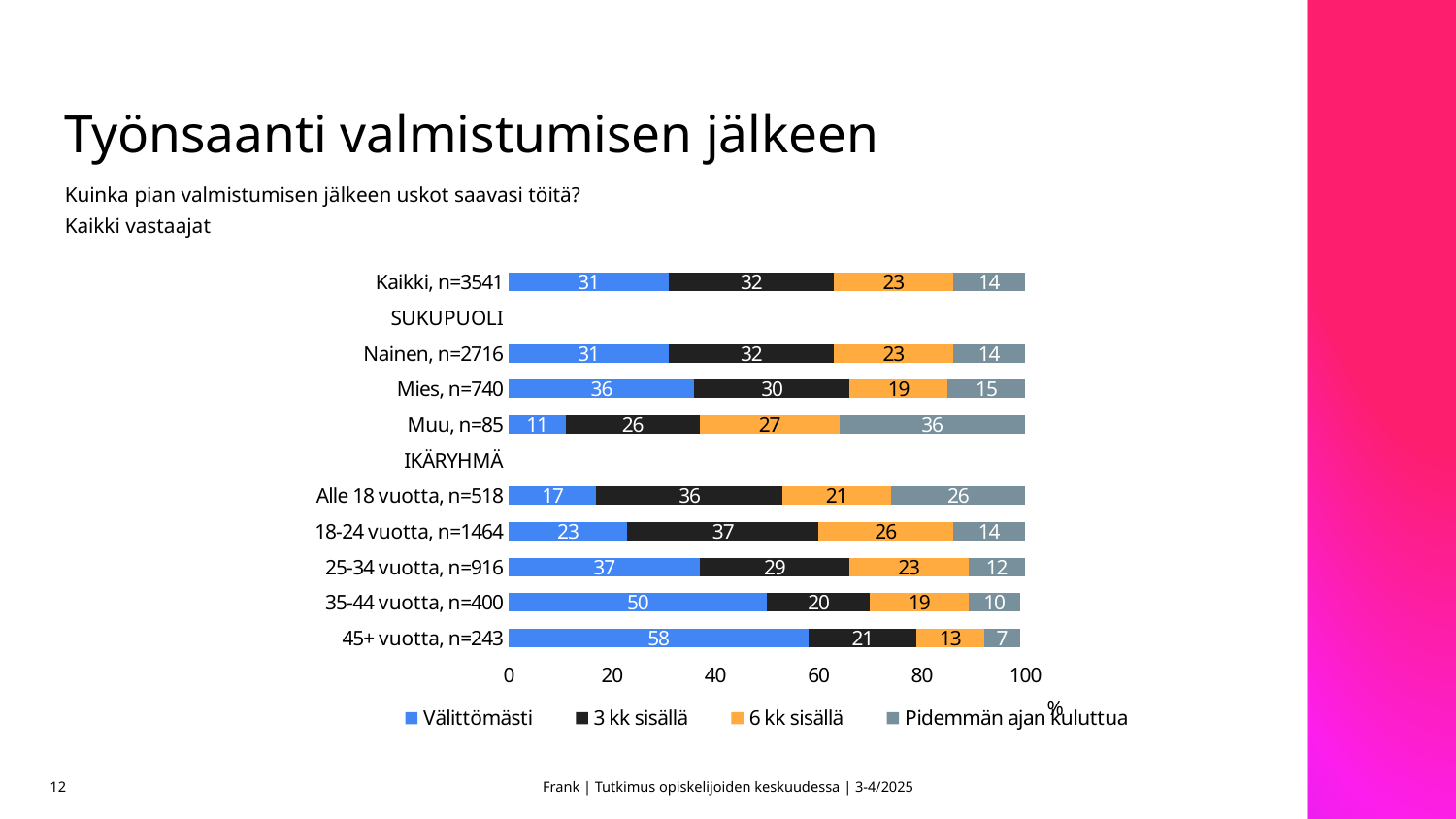
Which is larger: the "Pidemmän ajan kuluttua" value for "Alle 18 vuotta, n=518" or for "25-34 vuotta, n=916"? Alle 18 vuotta, n=518 What is the difference between the "Välittömästi" values for "Mies, n=740" and "Nainen, n=2716"? 5 Which series is shown in orange in the legend? 6 kk sisällä How many series does the legend list? 4 Which category has the lowest value for "Välittömästi"? Muu, n=85 What is the value for "Välittömästi" for the category "45+ vuotta, n=243"? 58 What is the value for "3 kk sisällä" for the category "18-24 vuotta, n=1464"? 37 What is the total of the stacked bar for "35-44 vuotta, n=400"? 99 What is the value for "Pidemmän ajan kuluttua" for the category "Muu, n=85"? 36 Which category has the highest value for "Välittömästi"? 45+ vuotta, n=243 What is the value for "6 kk sisällä" for the category "Kaikki, n=3541"? 23 What kind of chart is shown on the slide? Stacked bar chart